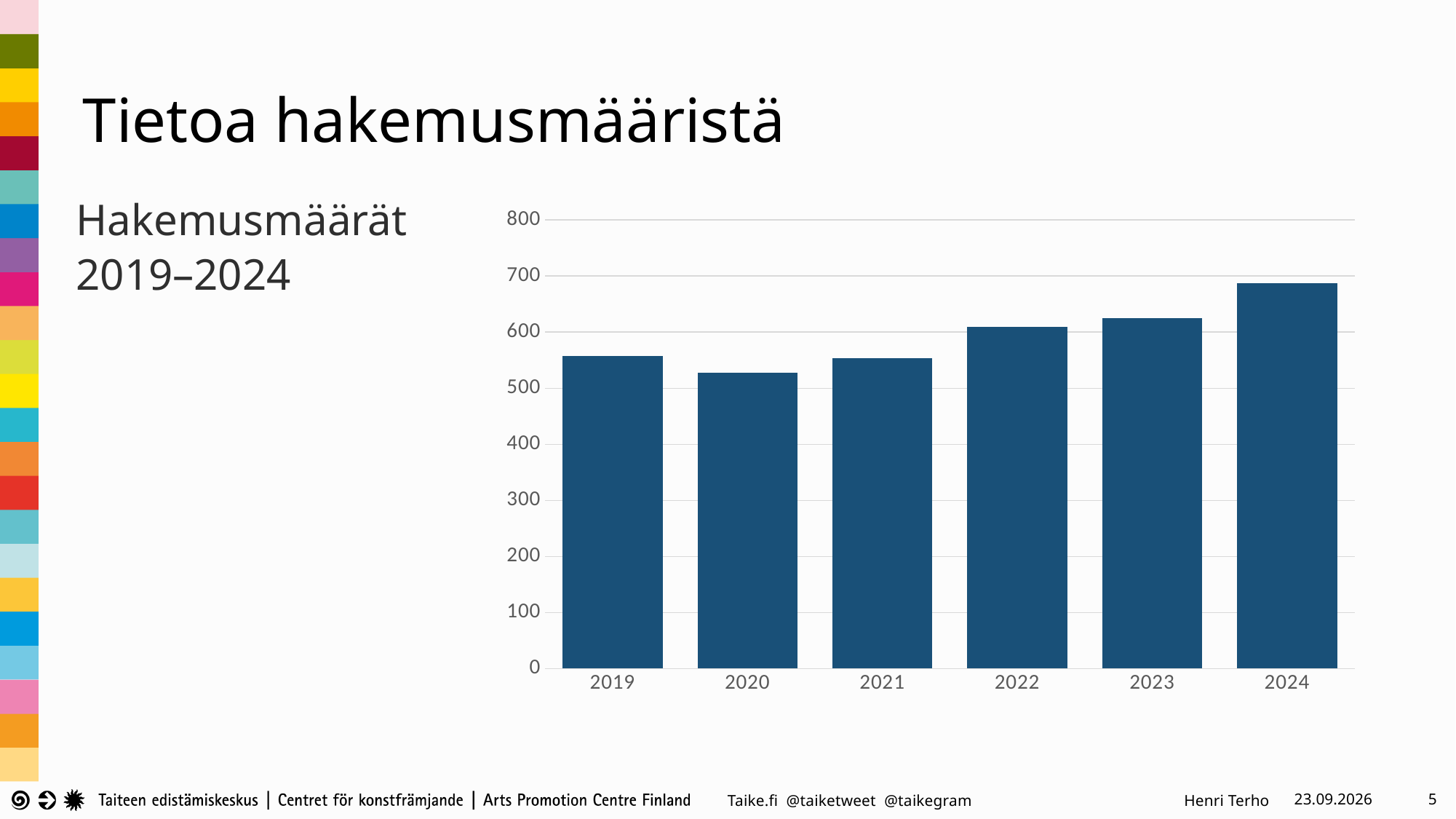
Is the value for 2020 greater or less than 500? greater Is the value for 2023 greater or less than 600? greater Do the values rise or fall from 2021 to 2024? rise Is the value for 2021 greater or less than 600? less Which year has the larger value, 2023 or 2024? 2024 What kind of chart is shown on the slide? bar chart Which year has the lowest number of applications in the chart? 2020 Which year has the highest number of applications in the chart? 2024 Which year has the larger value, 2020 or 2022? 2022 How many years are shown on the x axis of the chart? 6 What is the title of the chart on the slide? Hakemusmäärät 2019–2024